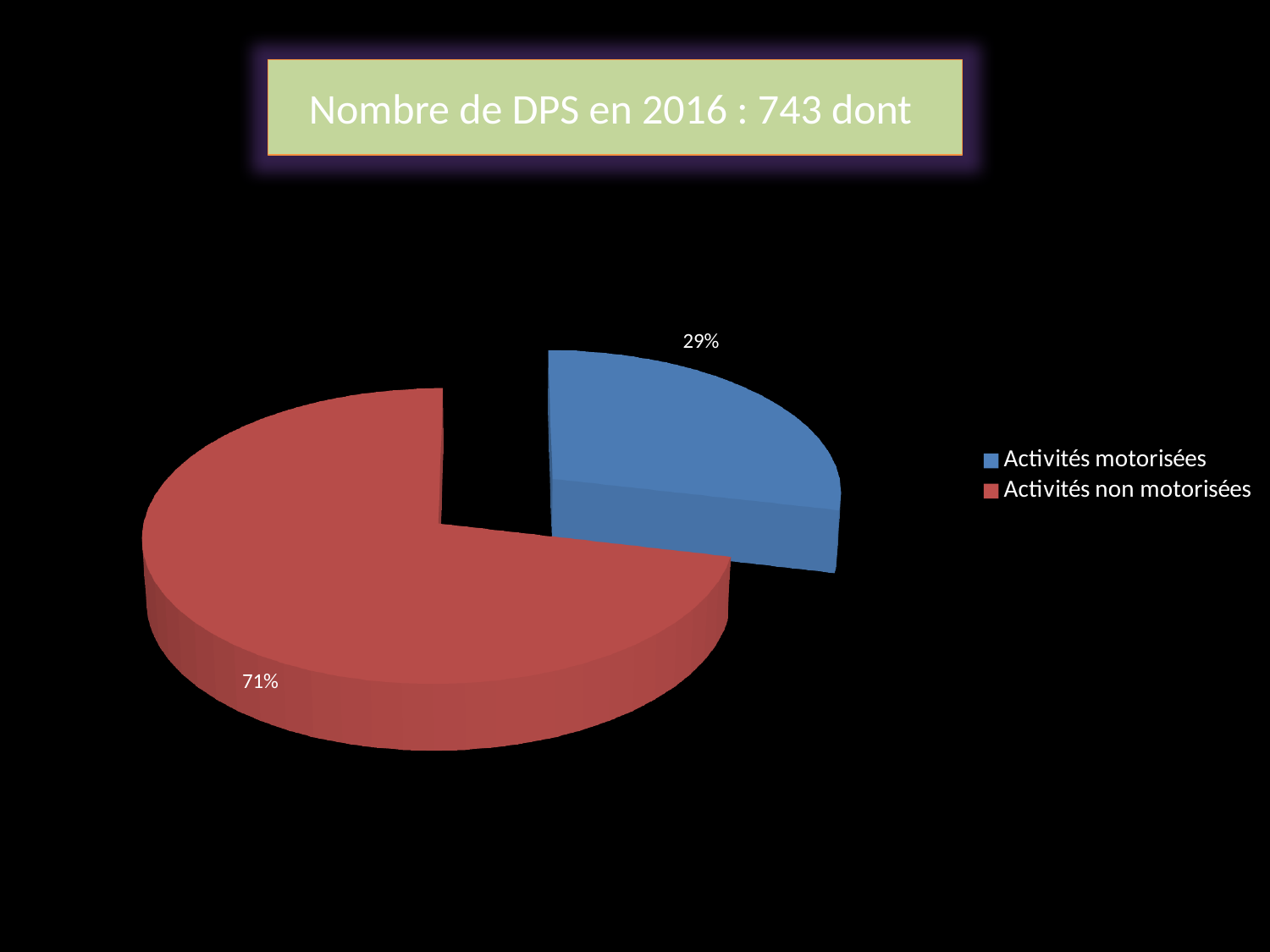
What colour is the slice for Activités motorisées? blue How many entries does the legend list? 2 What share of the pie is Activités non motorisées? 71% Which category has the largest share of the pie? Activités non motorisées What is the difference in percentage points between Activités non motorisées and Activités motorisées? 42 What share of the pie is Activités motorisées? 29% What kind of chart is shown on the slide? pie chart Which category has the smallest share of the pie? Activités motorisées Which is larger, the share for Activités motorisées or the share for Activités non motorisées? Activités non motorisées How many slices does the pie chart have? 2 What is the title shown above the chart? Nombre de DPS en 2016 : 743 dont